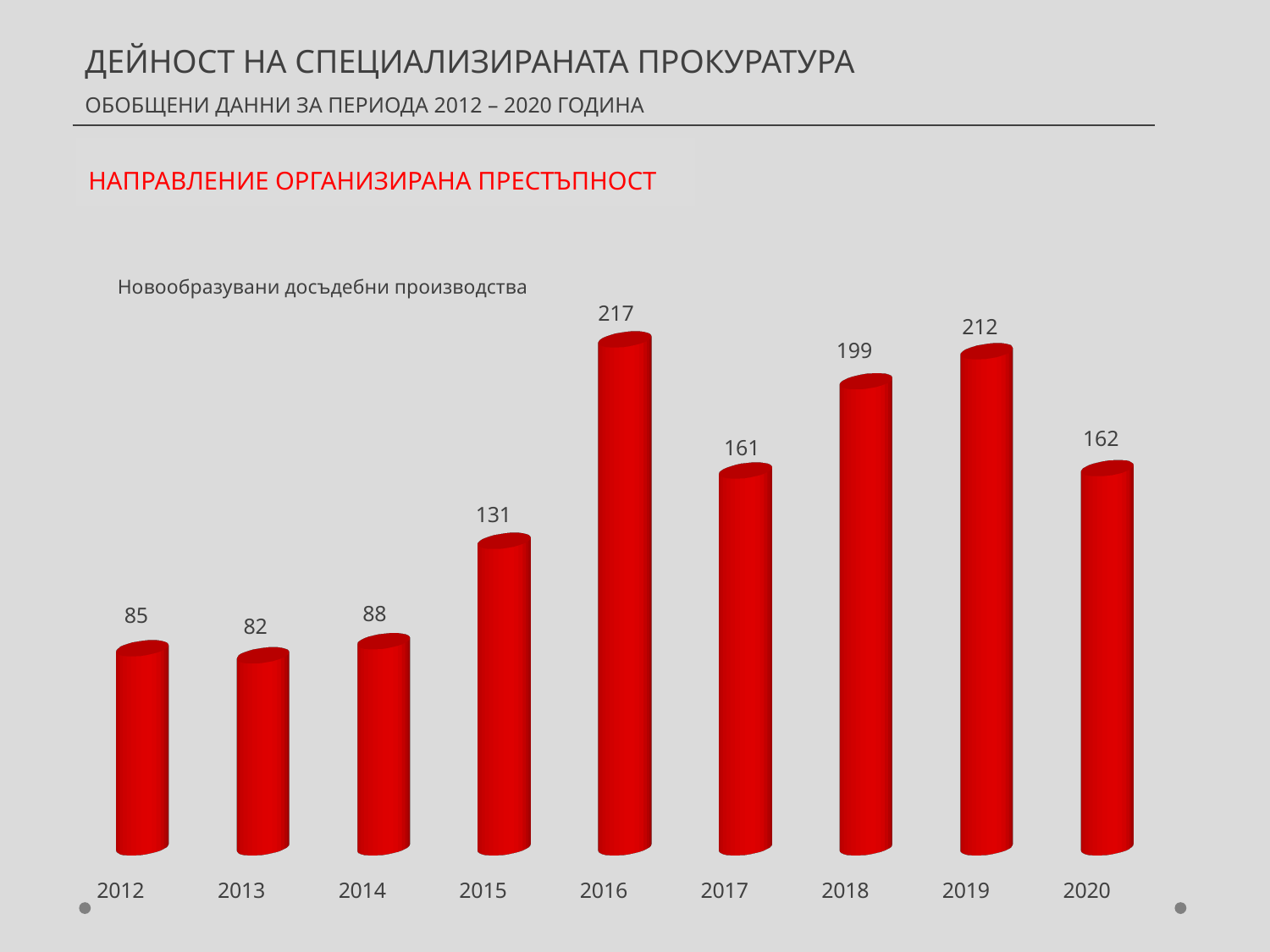
What is the value for 2013? 82 Do the values rise or fall from 2012 to 2016? rise (with a small dip in 2013) What is the value for 2016? 217 What is the difference between the values for 2016 and 2015? 86 What is the title of the chart? Новообразувани досъдебни производства Which year has the lowest value? 2013 What is the difference between the values for 2019 and 2020? 50 How many years are shown on the x axis? 9 Which year has the highest value? 2016 What is the value for 2020? 162 What kind of chart is this? bar chart Which is larger, the value for 2018 or the value for 2017? 2018